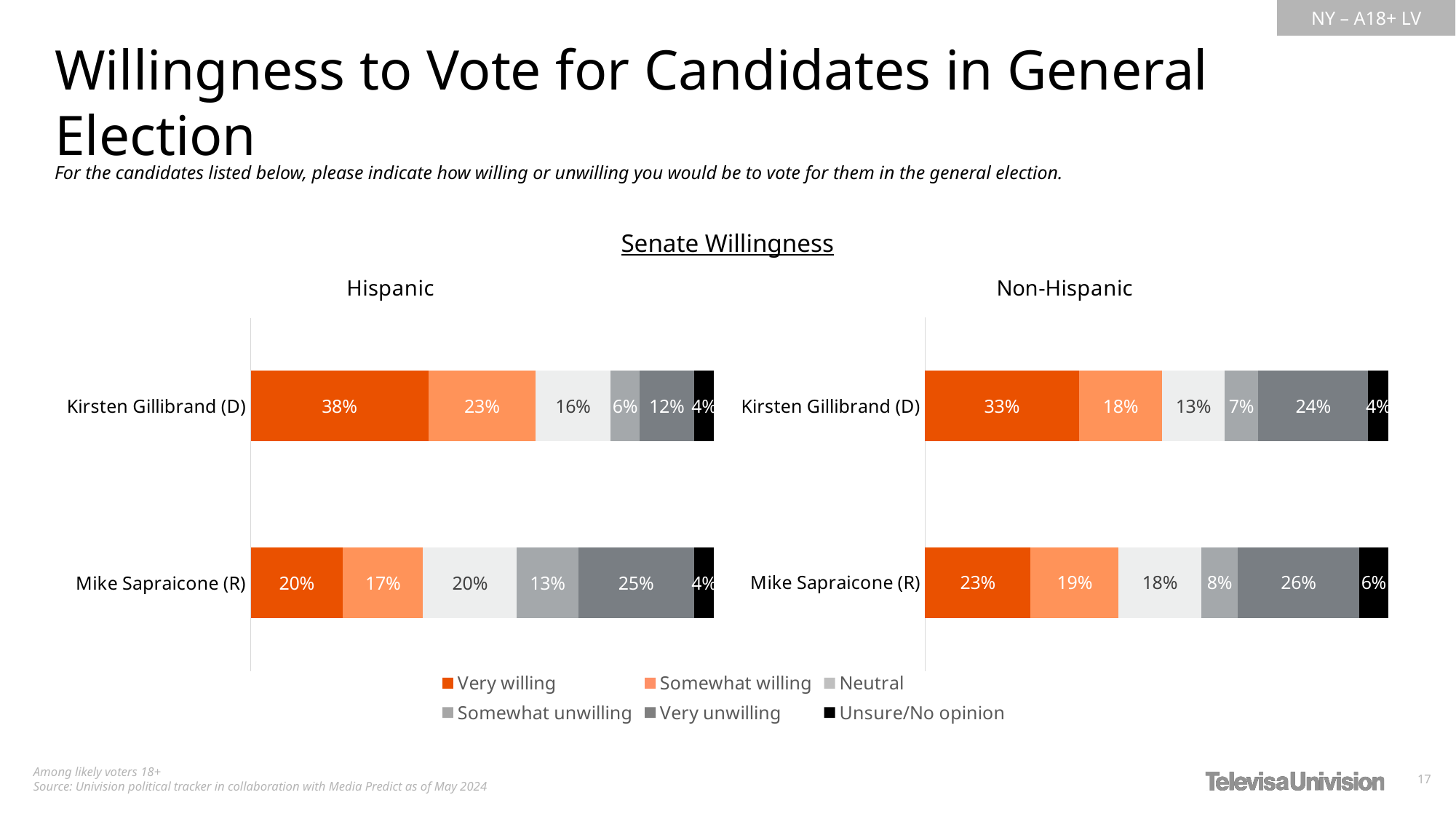
In the Non-Hispanic chart, what percentage of respondents are very unwilling to vote for Mike Sapraicone (R)? 26% In the Hispanic chart, what percentage of respondents are very willing to vote for Kirsten Gillibrand (D)? 38% In the Non-Hispanic chart, which candidate has the lower unsure/no opinion percentage? Kirsten Gillibrand (D) How many series does the legend list? 6 In the Hispanic chart, what percentage of respondents are neutral about voting for Mike Sapraicone (R)? 20% In the Non-Hispanic chart, what percentage of respondents are somewhat willing to vote for Kirsten Gillibrand (D)? 18% In the Hispanic chart, which candidate has the higher very willing percentage? Kirsten Gillibrand (D) In the Non-Hispanic chart, what is the total of the printed segment values for Mike Sapraicone (R)? 100% How many candidates are shown in the Hispanic chart? 2 In the Non-Hispanic chart, is the very unwilling percentage larger for Kirsten Gillibrand (D) or Mike Sapraicone (R)? Mike Sapraicone (R) What kind of chart is the Non-Hispanic chart? Stacked bar chart In the Hispanic chart, what is the difference between the very willing percentages for Kirsten Gillibrand (D) and Mike Sapraicone (R)? 18%